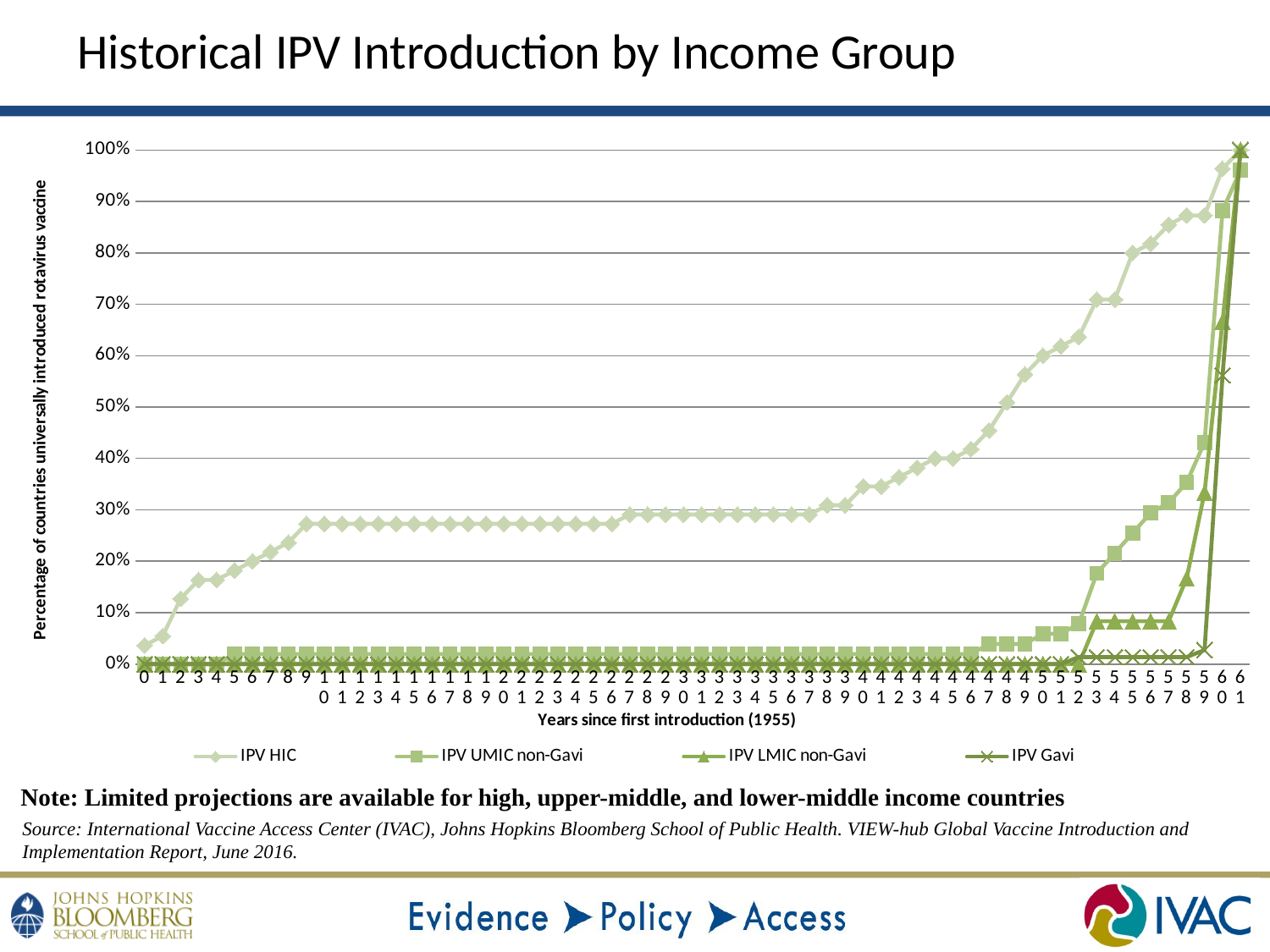
Is the value for IPV HIC at year 30 greater or less than 20%? greater Is the value for IPV HIC at year 0 greater or less than 10%? less What are the four series listed in the legend? IPV HIC, IPV UMIC non-Gavi, IPV LMIC non-Gavi, IPV Gavi Is the value for IPV Gavi at year 60 greater or less than 40%? greater What is the title of the x axis? Years since first introduction (1955) How many series does the legend list? 4 What kind of chart is shown on the slide? line chart At year 50, which is larger: IPV HIC or IPV UMIC non-Gavi? IPV HIC Does the IPV HIC series generally rise or fall as years since first introduction increase? rise Which series has the highest value at year 20? IPV HIC